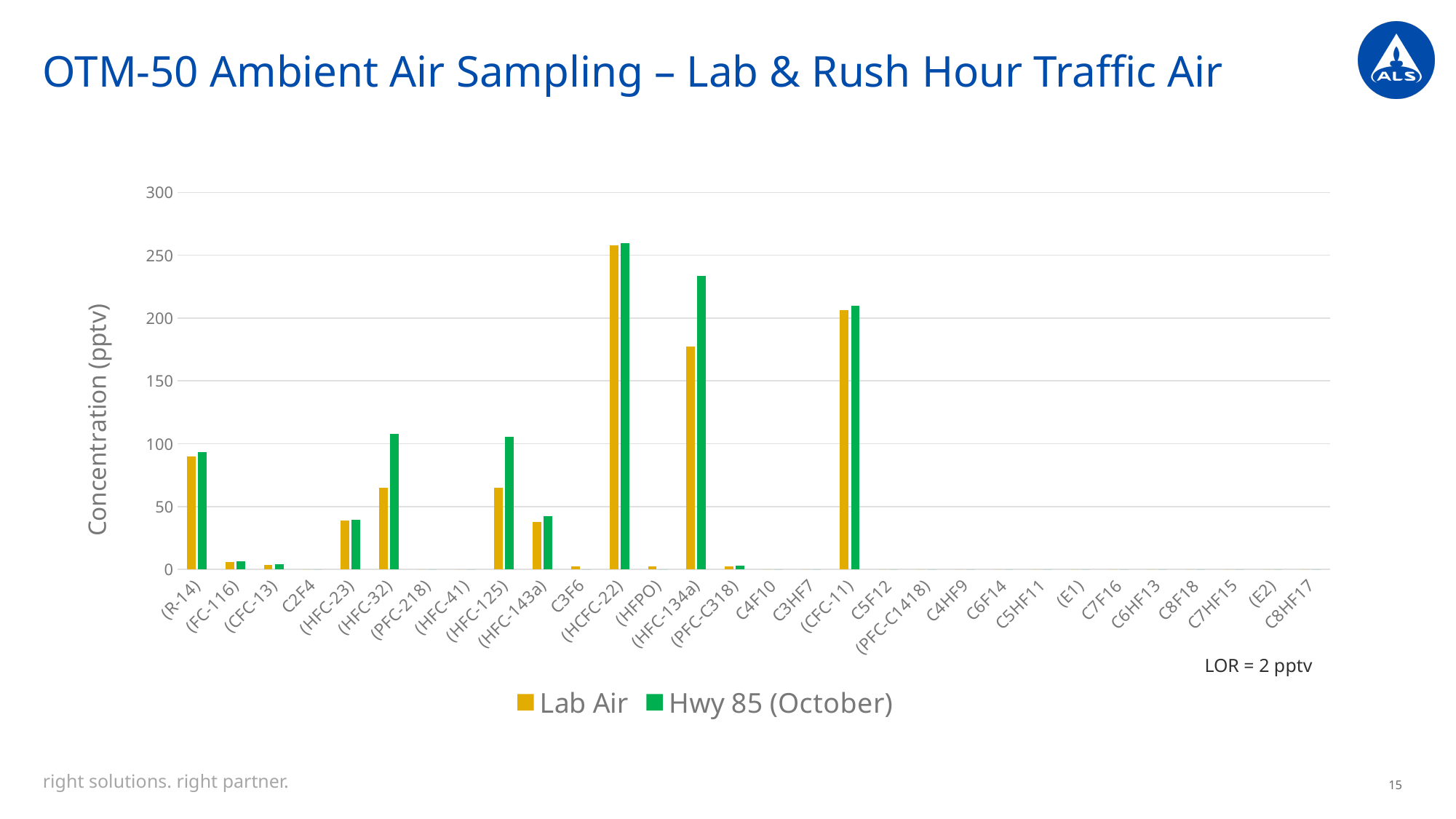
Is the Lab Air value for (HFC-134a) greater or less than 200? less Which category has the highest Hwy 85 (October) concentration? (HCFC-22) Which category has the highest Lab Air concentration? (HCFC-22) Is the Hwy 85 (October) value for (HFC-134a) greater or less than 200? greater What kind of chart is shown on the slide? bar chart Is the Hwy 85 (October) value for (HFC-32) greater or less than 100? greater How many series does the legend list? 2 For (HFC-134a), which series has the larger value, Lab Air or Hwy 85 (October)? Hwy 85 (October) For (HFC-125), which series has the larger value, Lab Air or Hwy 85 (October)? Hwy 85 (October) What is the label of the vertical axis? Concentration (pptv)